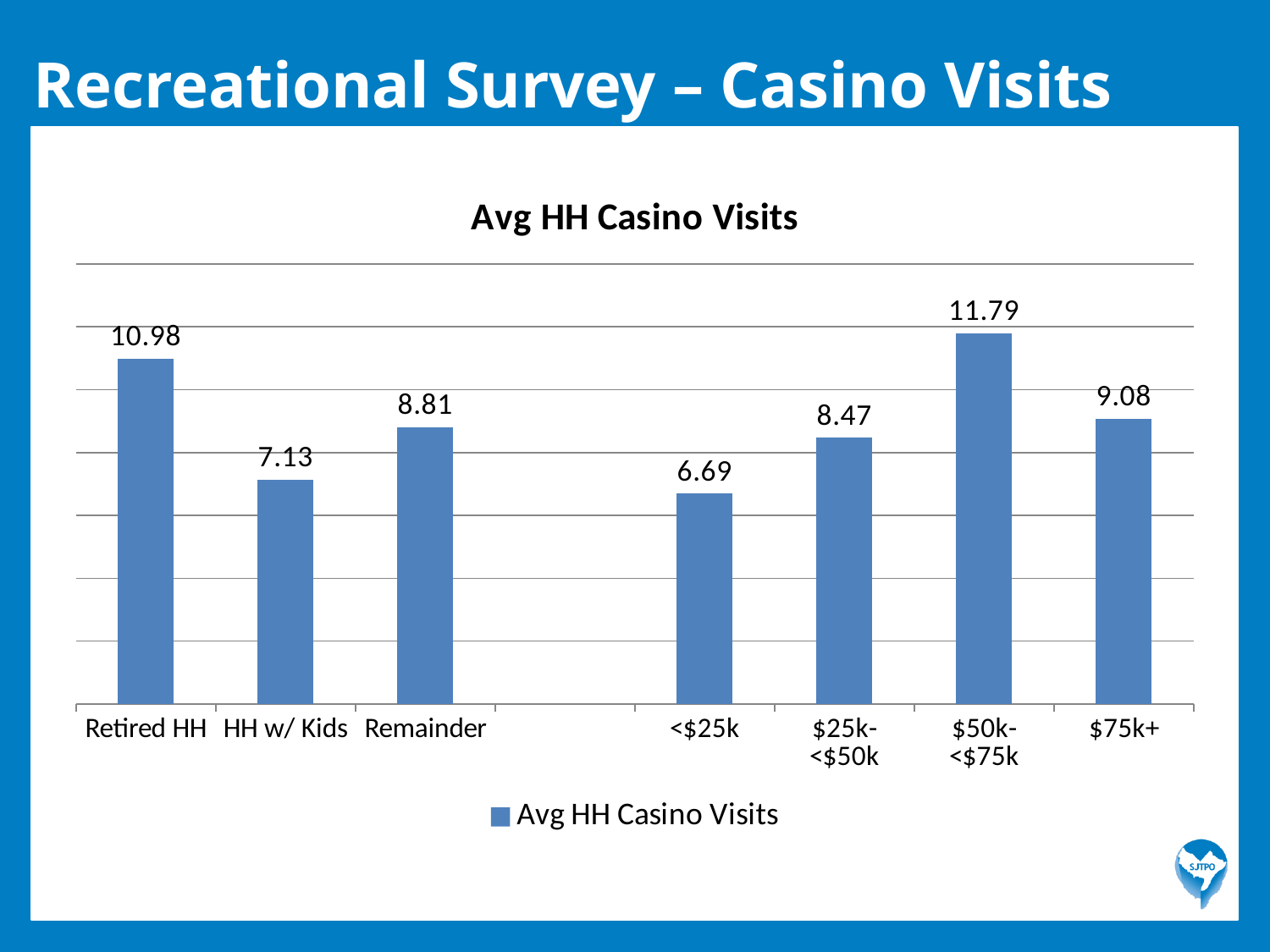
How many bars are plotted in the chart? 7 Which category has the highest average HH casino visits? $50k-<$75k What is the value shown for the $50k-<$75k income group? 11.79 What is the value shown for the <$25k income group? 6.69 What is the value shown for HH w/ Kids? 7.13 What is the difference between the values for $50k-<$75k and <$25k? 5.10 How many series does the legend list? 1 What is the average HH casino visits value for Retired HH? 10.98 What is the difference between the values for Retired HH and HH w/ Kids? 3.85 What type of chart is shown on the slide? Bar chart Which category has the lowest average HH casino visits? <$25k Which is larger, the value for Remainder or the value for $25k-<$50k? Remainder